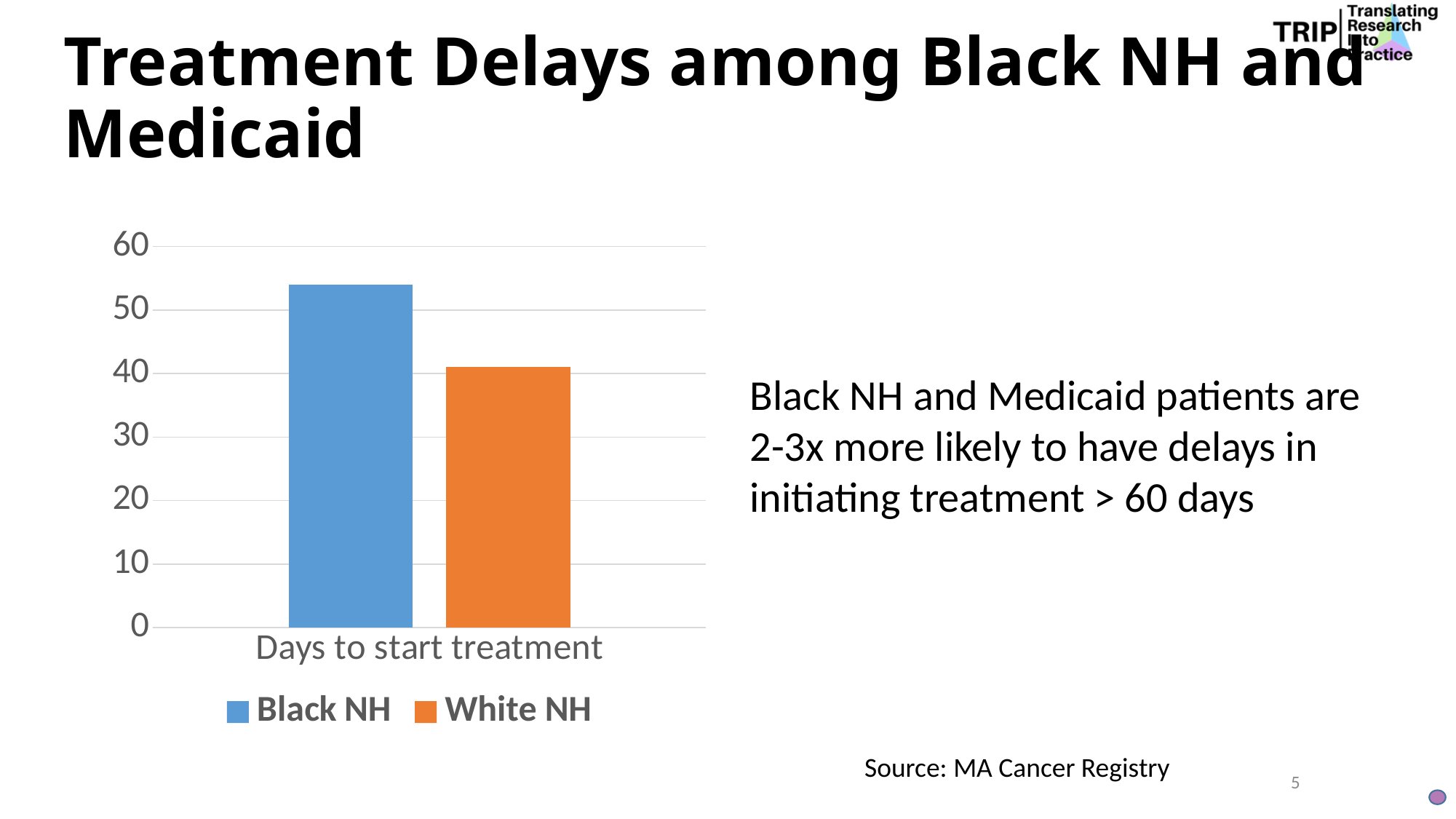
Which series has the lower value for Days to start treatment? White NH Which series has the higher value for Days to start treatment? Black NH What kind of chart is shown on the slide? bar chart Is the value for White NH greater or less than 50? less How many series does the chart legend list? 2 Is the value for White NH greater or less than 30? greater Which is larger: the value for Black NH or the value for White NH? Black NH Is the value for Black NH greater or less than 60? less How many categories are shown on the x axis of the chart? 1 What is the category label on the x axis of the chart? Days to start treatment What colour is the bar for White NH in the chart? orange